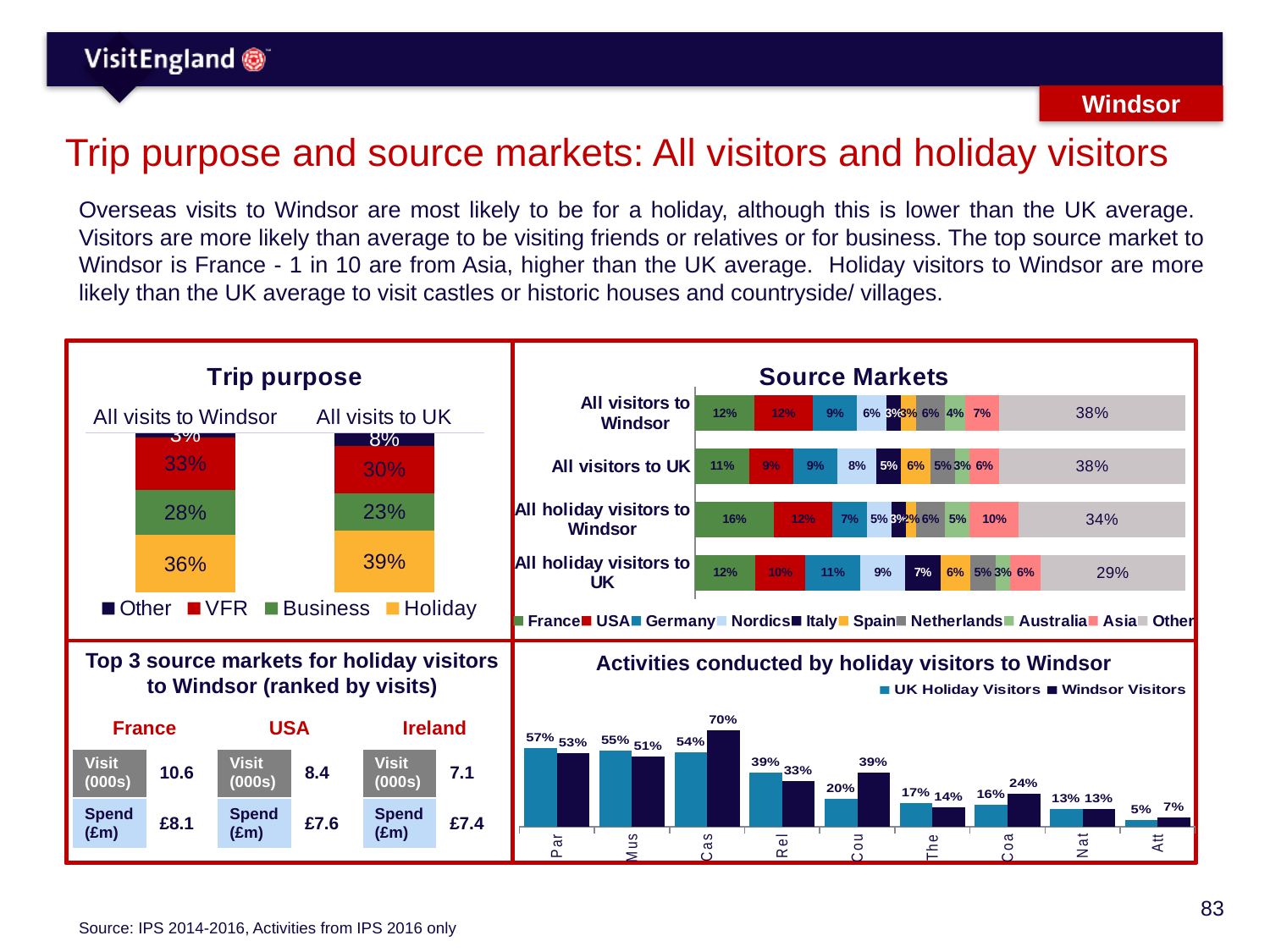
In the Trip purpose chart, what share of all visits to the UK are for Business? 23% In the Trip purpose chart, what is the difference between the VFR share for all visits to Windsor and for all visits to the UK? 3 percentage points In the Source Markets chart, how many visitor groups (bars) are shown? 4 In the Activities conducted by holiday visitors to Windsor chart, what is the Windsor Visitors value for the category labelled 'Cas'? 70% In the Trip purpose chart, what share of all visits to Windsor are for Holiday? 36% In the Source Markets chart, how many series does the legend list? 10 What type of chart is the Activities conducted by holiday visitors to Windsor chart? Bar chart In the Source Markets chart, which is larger: the Asia share for all holiday visitors to Windsor or for all holiday visitors to the UK? All holiday visitors to Windsor In the Source Markets chart, what share of all holiday visitors to Windsor come from France? 16% In the Activities conducted by holiday visitors to Windsor chart, which category has the highest Windsor Visitors value? Cas In the Source Markets chart, what share of all visitors to Windsor fall into the Other category? 38% In the Trip purpose chart, how many series does the legend list? 4